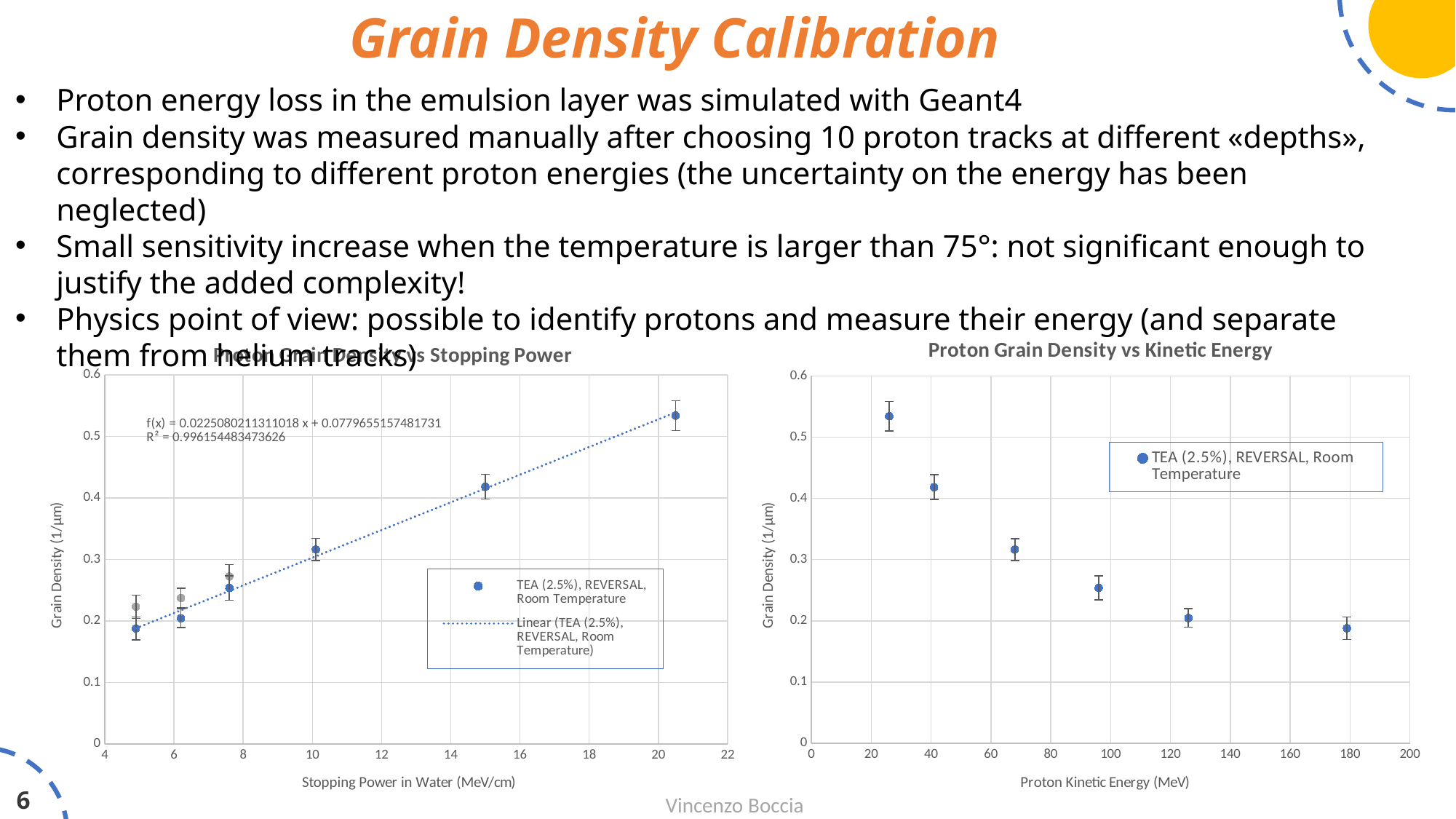
In the 'Proton Grain Density vs Kinetic Energy' chart, does the highest grain density occur at the lowest or the highest kinetic energy? lowest What kind of chart is the 'Proton Grain Density vs Kinetic Energy' chart on the right? scatter chart In the 'Proton Grain Density vs Kinetic Energy' chart, is the grain density of the point at the lowest kinetic energy greater or less than 0.5? greater In the 'Proton Grain Density vs Stopping Power' chart on the left, do the blue data points rise or fall as stopping power increases? rise In the 'Proton Grain Density vs Stopping Power' chart, is the grain density of the blue point near 10 MeV/cm greater or less than 0.4? less How many data points are plotted in the 'Proton Grain Density vs Kinetic Energy' chart? 6 In the 'Proton Grain Density vs Kinetic Energy' chart, does grain density rise or fall as proton kinetic energy increases? fall In the 'Proton Grain Density vs Kinetic Energy' chart, is the grain density of the point near 120 MeV greater or less than 0.3? less What R² value is printed on the 'Proton Grain Density vs Stopping Power' chart? 0.996154483473626 How many entries does the legend of the 'Proton Grain Density vs Kinetic Energy' chart list? 1 How many entries does the legend of the 'Proton Grain Density vs Stopping Power' chart list? 2